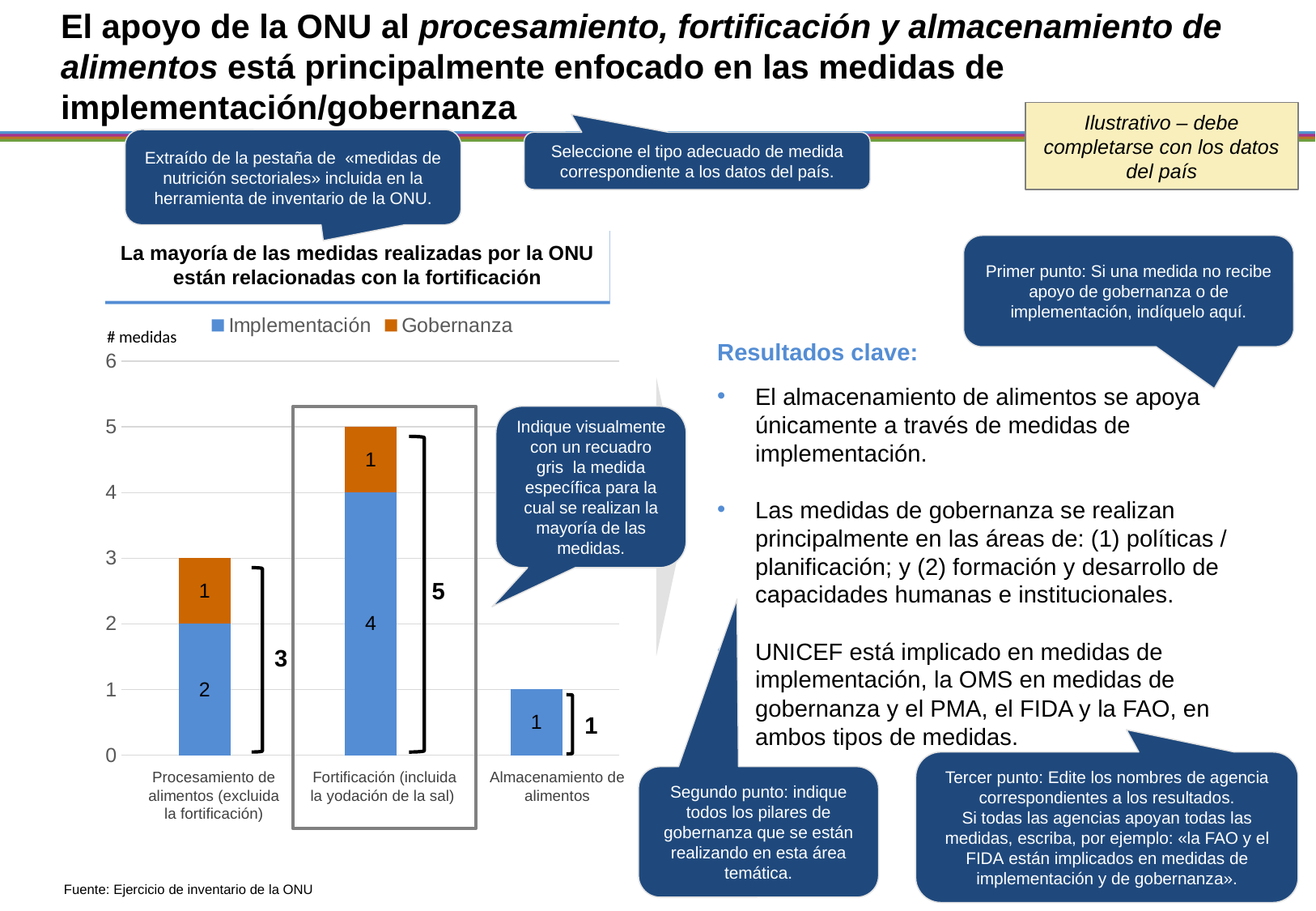
What is the Gobernanza value for Procesamiento de alimentos (excluida la fortificación)? 1 What is the Implementación value for Almacenamiento de alimentos? 1 Which category has the lowest total number of measures? Almacenamiento de alimentos What is the total number of measures for Procesamiento de alimentos (excluida la fortificación)? 3 What is the total number of measures for Fortificación (incluida la yodación de la sal)? 5 What is the Implementación value for Fortificación (incluida la yodación de la sal)? 4 How many categories are shown on the x axis of the chart? 3 Which series is shown in orange in the chart legend? Gobernanza What type of chart is shown on the slide? Stacked bar chart How many series does the chart legend list? 2 Which category has the highest total number of measures? Fortificación (incluida la yodación de la sal) What is the difference between the Implementación values for Fortificación and Procesamiento de alimentos? 2